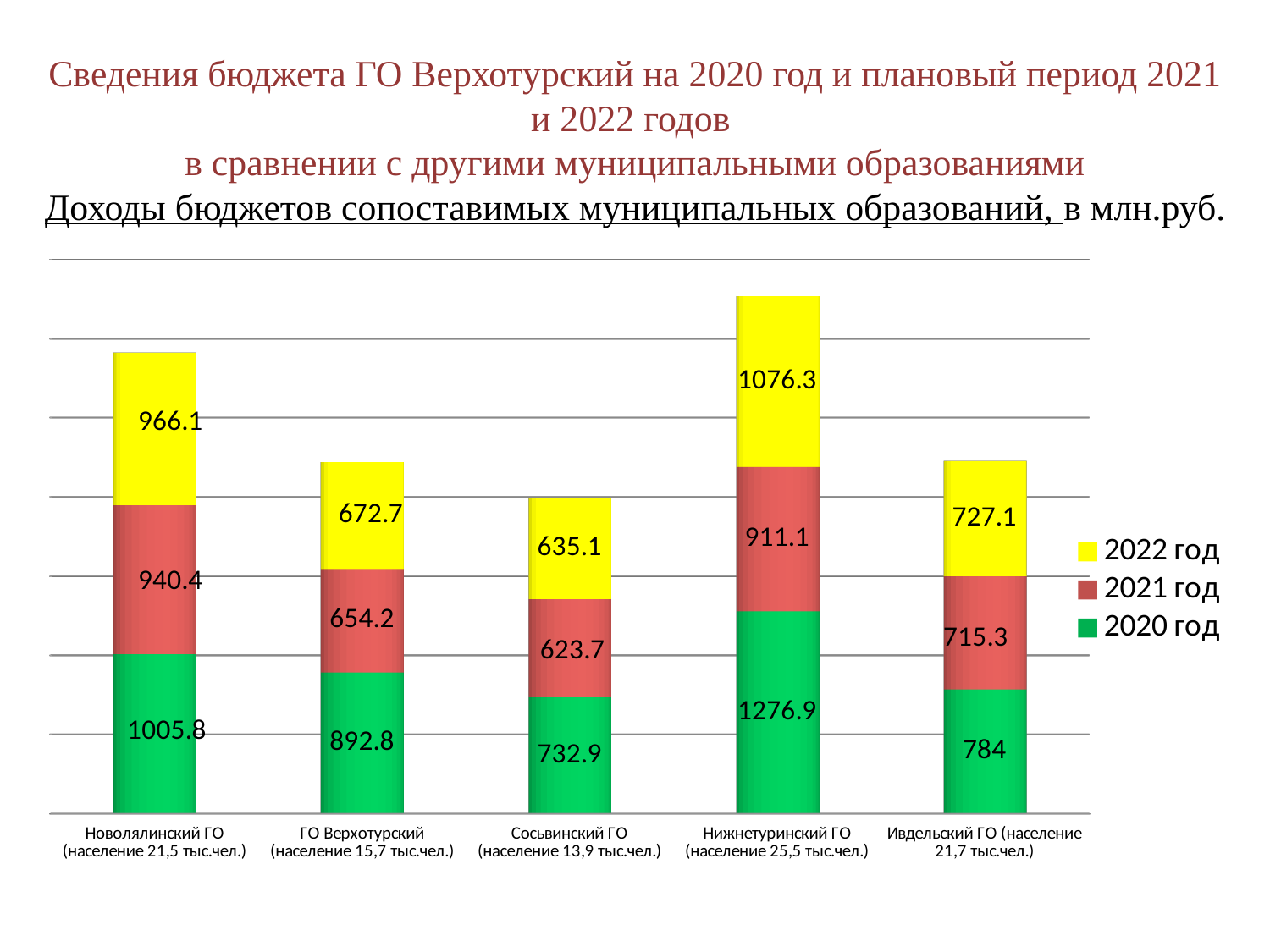
What is the 2020 год value for ГО Верхотурский? 892.8 What type of chart is shown on the slide? Stacked bar chart How many municipalities (categories) are shown on the x axis? 5 What is the difference between the 2020 год values of Новолялинский ГО and Сосьвинский ГО? 272.9 Which municipality has the highest 2020 год value? Нижнетуринский ГО What is the total of the stacked bar for ГО Верхотурский? 2219.7 How many series does the legend list? 3 What is the 2021 год value for Ивдельский ГО? 715.3 Which colour represents 2022 год in the legend? Yellow What is the 2022 год value for Нижнетуринский ГО? 1076.3 Which is larger: the 2022 год value for Ивдельский ГО or for ГО Верхотурский? Ивдельский ГО Which municipality has the lowest 2021 год value? Сосьвинский ГО